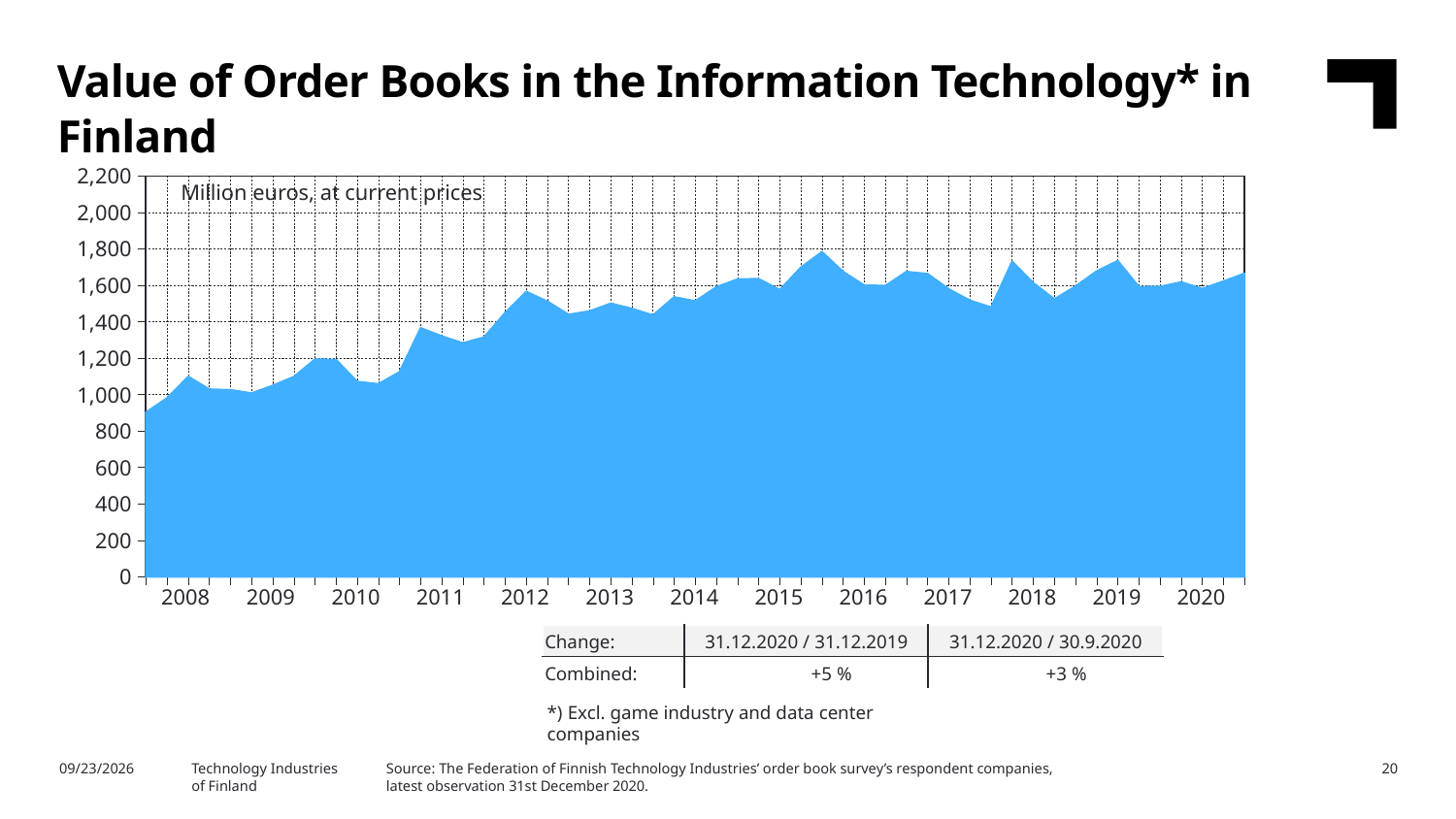
What is the highest value shown on the y axis of the chart? 2,200 What kind of chart is shown on the slide? Area chart Is the highest value reached around 2015–2016 greater or less than 1,600? greater Overall, do the values rise or fall from 2008 to 2020? Rise What is the title of the chart? Value of Order Books in the Information Technology* in Finland In what unit are the values on the chart expressed, according to the label inside the plot area? Million euros, at current prices Is the value at any point on the chart greater or less than 2,000? less Is the value at the end of 2020 greater or less than 1,400? greater How many years are labelled on the x axis of the chart? 13